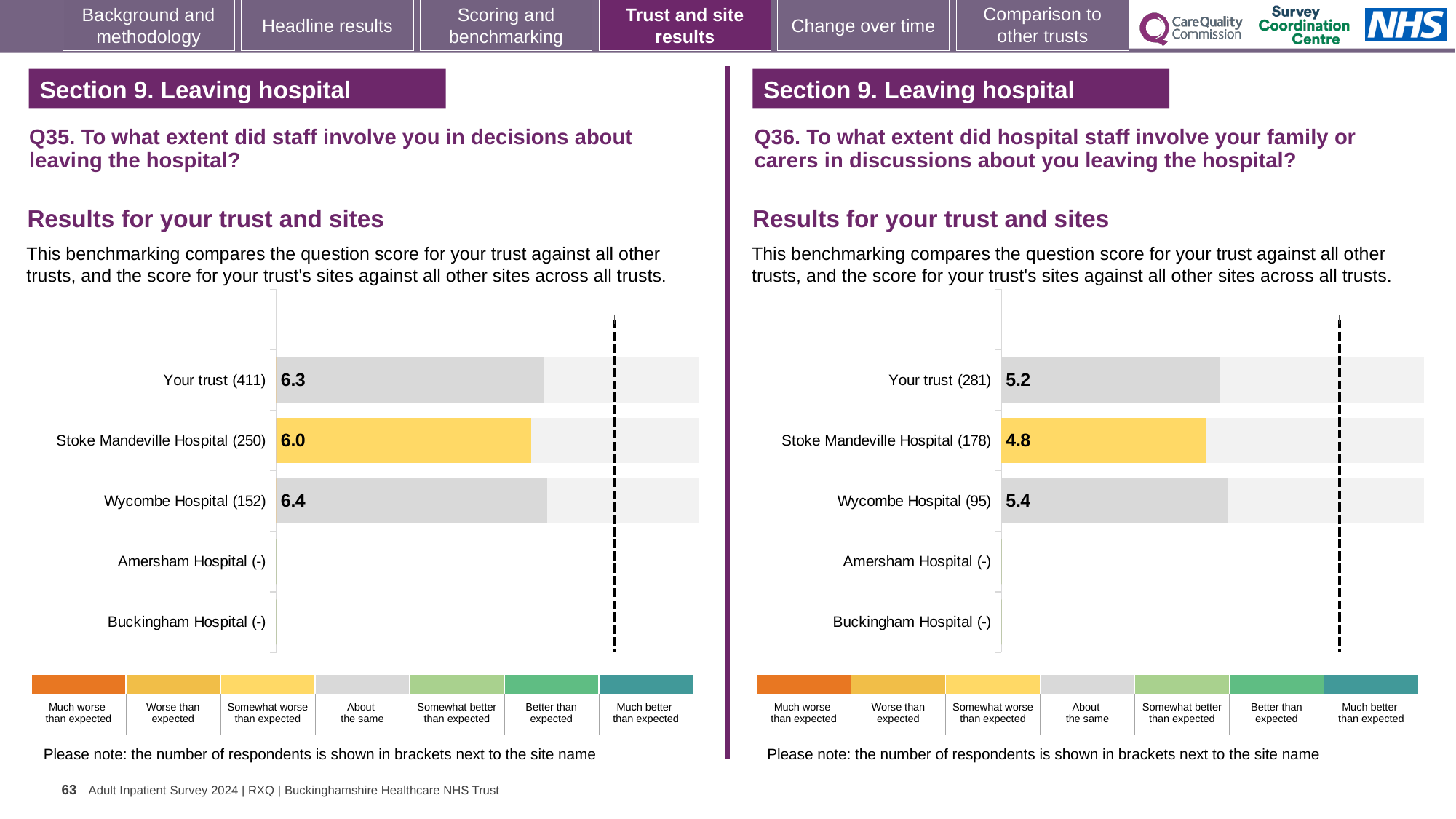
On the Q35 chart (left), what is the score for Your trust? 6.3 On the Q36 chart (right), how many respondents are shown in brackets for Stoke Mandeville Hospital? 178 On the Q36 chart (right), which has the larger score, Your trust or Stoke Mandeville Hospital? Your trust On the Q35 chart (left), what is the difference between the scores for Wycombe Hospital and Stoke Mandeville Hospital? 0.4 On the Q35 chart (left), what is the score for Stoke Mandeville Hospital? 6.0 On the Q36 chart (right), what is the score for Wycombe Hospital? 5.4 On the Q36 chart (right), what is the score for Your trust? 5.2 On the Q35 chart (left), which site has the highest score? Wycombe Hospital How many site rows are listed on the Q35 chart (left), including Your trust? 5 On the Q36 chart (right), what is the difference between the scores for Your trust and Stoke Mandeville Hospital? 0.4 On the Q36 chart (right), which site has the lowest score? Stoke Mandeville Hospital What kind of chart is used on the Q35 chart (left)? Bar chart